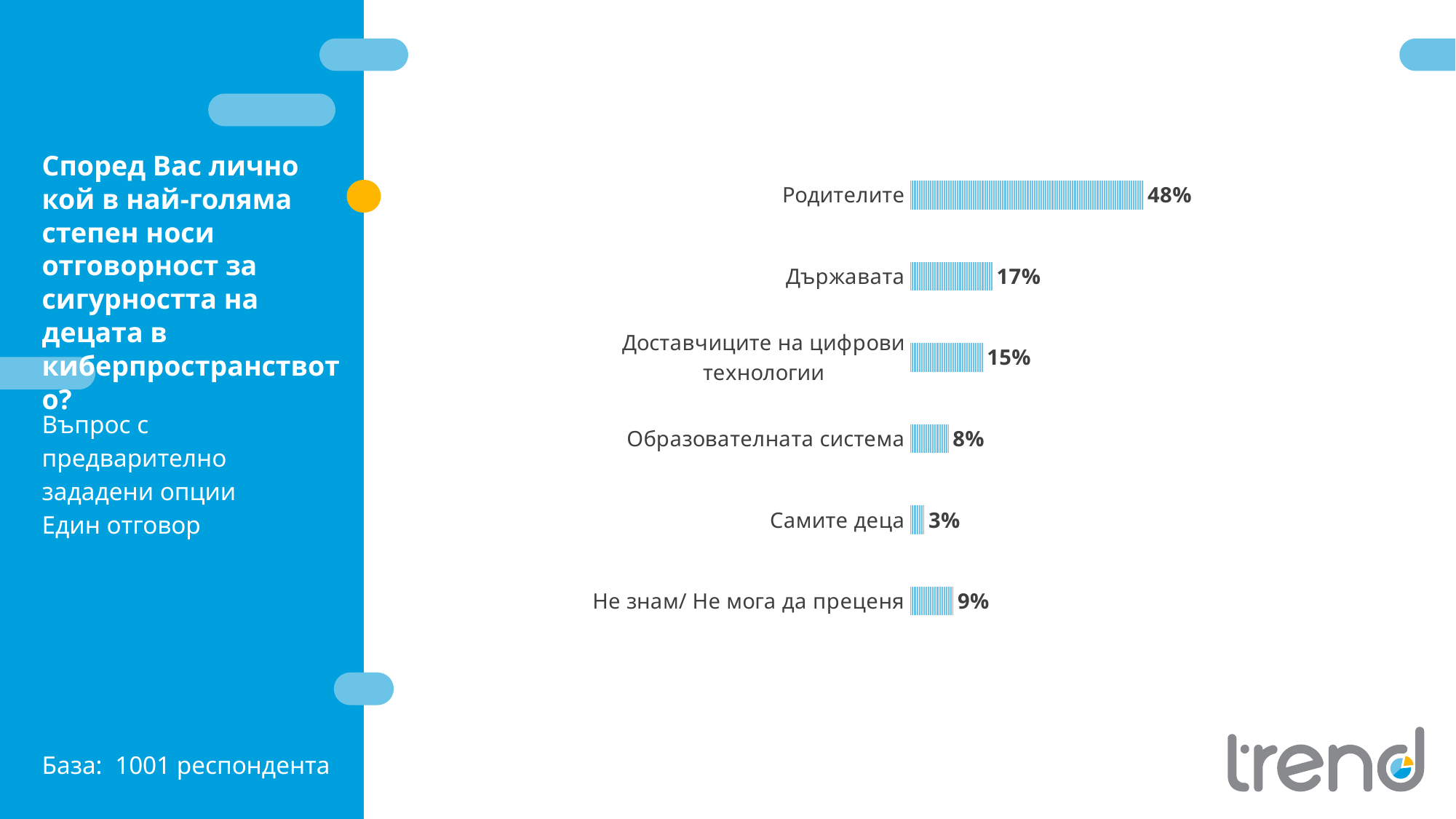
What is the value for Не знам/ Не мога да преценя? 9% What is the value for Образователната система? 8% How many categories are shown in the chart? 6 What kind of chart is shown on the slide? Bar chart Which category has the lowest value? Самите деца What is the value for Доставчиците на цифрови технологии? 15% What is the value for Самите деца? 3% Which category has the highest value? Родителите What is the value for Родителите? 48% Which is larger, the value for Образователната система or the value for Не знам/ Не мога да преценя? Не знам/ Не мога да преценя What is the difference between the values for Родителите and Държавата? 31% What is the value for Държавата? 17%